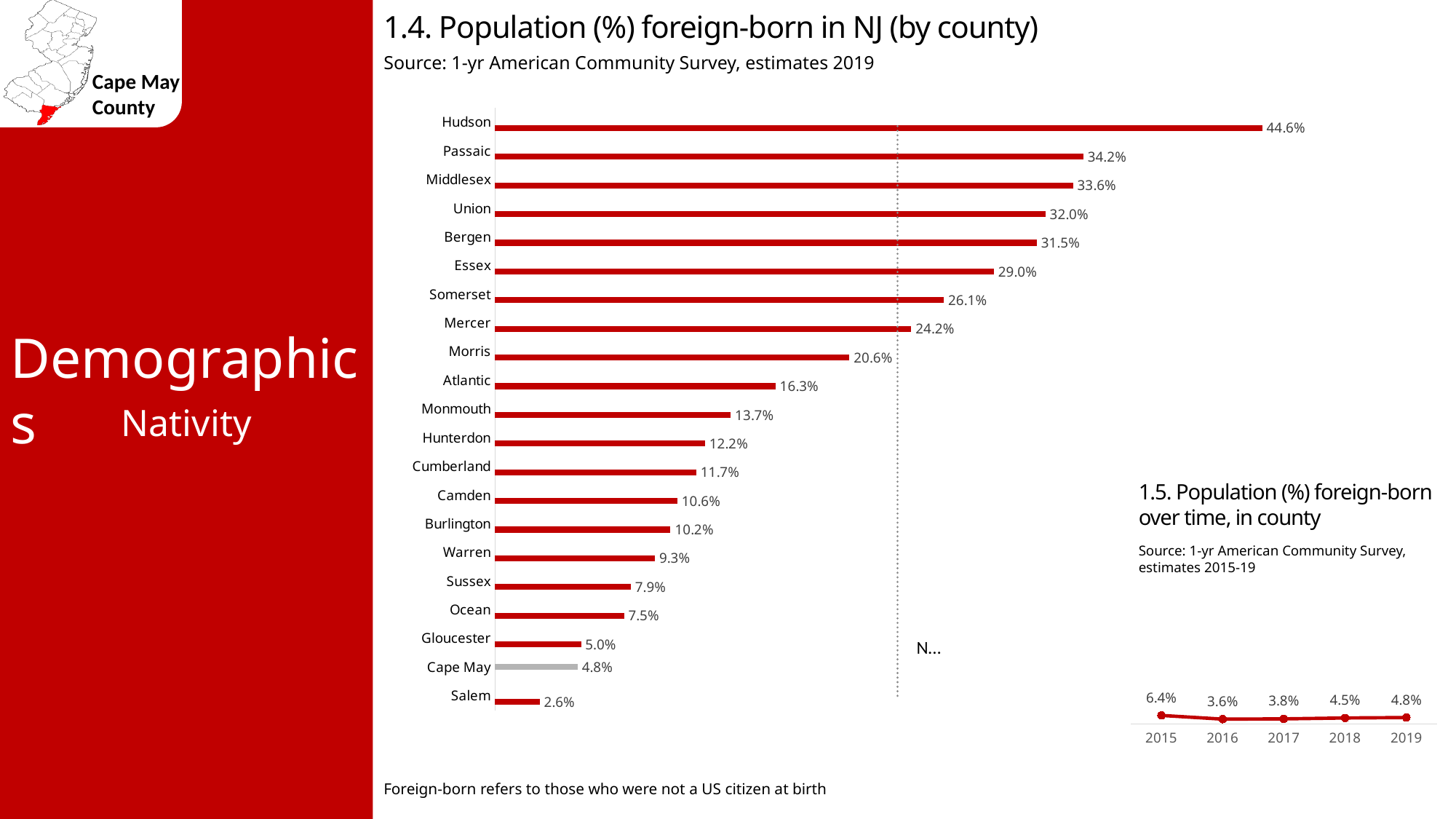
What kind of chart is '1.4. Population (%) foreign-born in NJ (by county)'? Bar chart How many counties are shown in the chart '1.4. Population (%) foreign-born in NJ (by county)'? 21 In the chart '1.5. Population (%) foreign-born over time, in county', what is the value for 2017? 3.8% In the chart '1.4. Population (%) foreign-born in NJ (by county)', what is the difference between Hudson and Passaic? 10.4% How many data points are plotted in the chart '1.5. Population (%) foreign-born over time, in county'? 5 In the chart '1.4. Population (%) foreign-born in NJ (by county)', what is the value for Bergen? 31.5% In the chart '1.4. Population (%) foreign-born in NJ (by county)', what is the value for Cape May? 4.8% In the chart '1.4. Population (%) foreign-born in NJ (by county)', which county has the highest value? Hudson In the chart '1.4. Population (%) foreign-born in NJ (by county)', which county has the lowest value? Salem In the chart '1.4. Population (%) foreign-born in NJ (by county)', which is larger, Gloucester or Cape May? Gloucester In the chart '1.5. Population (%) foreign-born over time, in county', what is the difference between 2019 and 2016? 1.2% In the chart '1.5. Population (%) foreign-born over time, in county', which year has the highest value? 2015